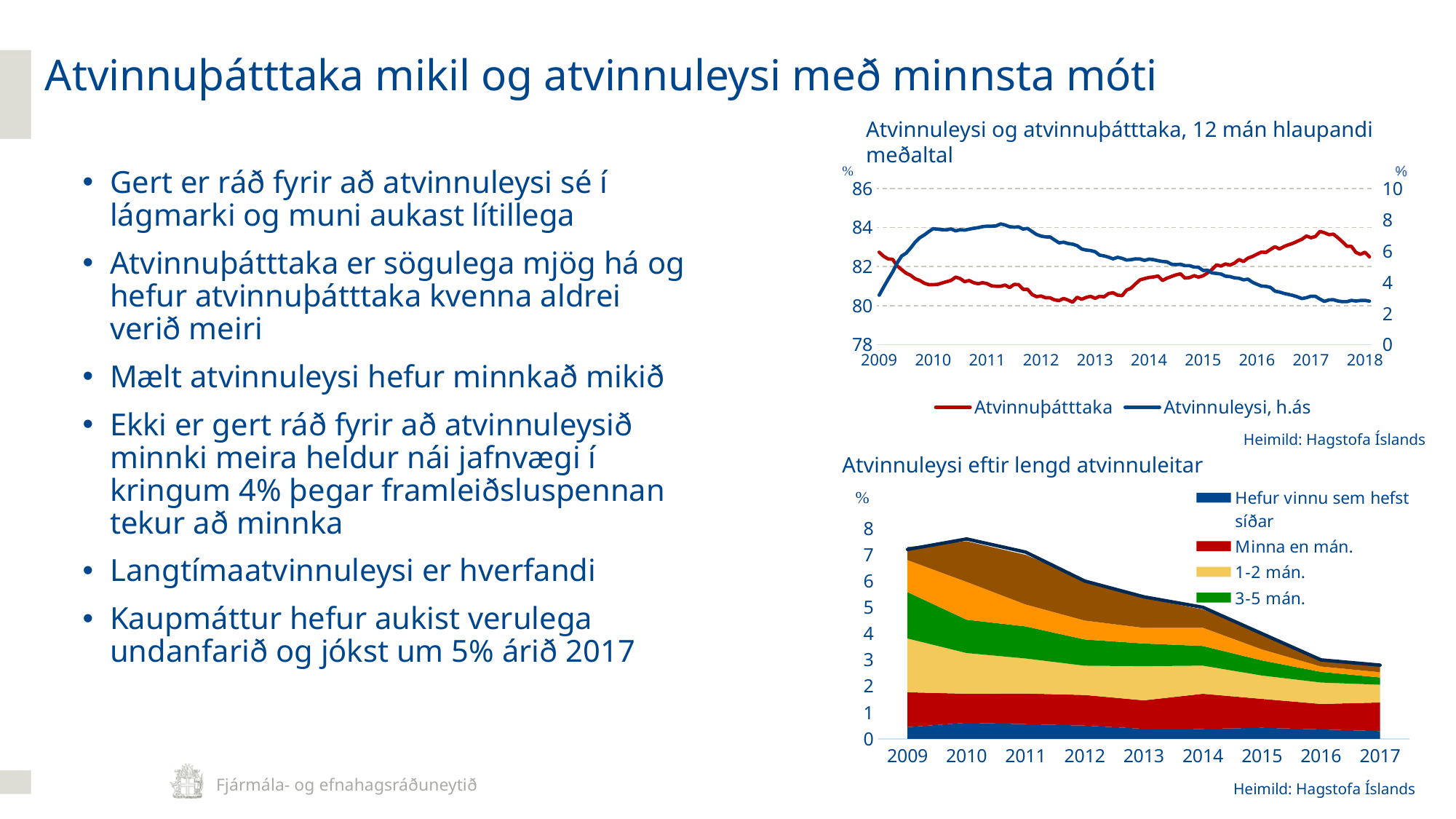
In the top chart (Atvinnuleysi og atvinnuþátttaka), is the Atvinnuleysi, h.ás value in 2018 greater or less than 4? less In the top chart (Atvinnuleysi og atvinnuþátttaka), does the Atvinnuþátttaka series rise or fall from 2013 to 2017? rise What is the title of the top chart on the slide? Atvinnuleysi og atvinnuþátttaka, 12 mán hlaupandi meðaltal In the bottom chart (Atvinnuleysi eftir lengd atvinnuleitar), is the total unemployment in 2017 greater or less than 4? less What kind of chart is the bottom chart (Atvinnuleysi eftir lengd atvinnuleitar)? stacked area chart In the top chart (Atvinnuleysi og atvinnuþátttaka), is the Atvinnuþátttaka value in 2013 greater or less than 82? less In the bottom chart (Atvinnuleysi eftir lengd atvinnuleitar), in which year is the total unemployment lowest? 2017 In the top chart (Atvinnuleysi og atvinnuþátttaka), how many years are labelled on the x axis? 10 In the top chart (Atvinnuleysi og atvinnuþátttaka), does the Atvinnuleysi, h.ás series rise or fall from 2011 to 2018? fall In the bottom chart (Atvinnuleysi eftir lengd atvinnuleitar), how many years are labelled on the x axis? 9 In the top chart (Atvinnuleysi og atvinnuþátttaka), how many series does the legend list? 2